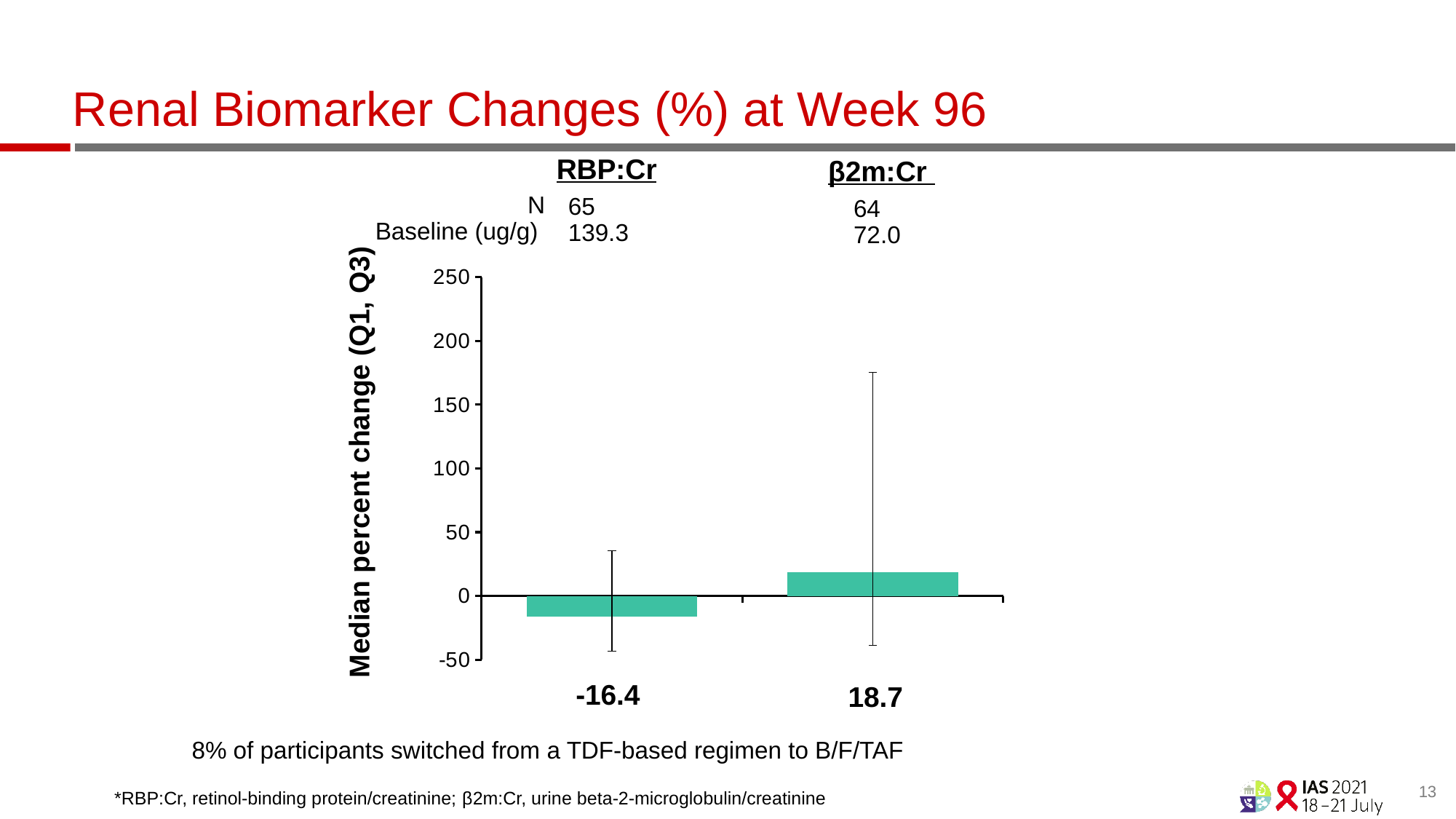
What is the median percent change for β2m:Cr? 18.7 Is the median percent change for β2m:Cr greater or less than 50? less What is the difference between the median percent change for β2m:Cr and RBP:Cr? 35.1 Is the median percent change for β2m:Cr larger than that for RBP:Cr? Yes How many biomarkers are plotted in the chart? 2 Is the median percent change for RBP:Cr greater or less than 0? less Which biomarker has the lower median percent change? RBP:Cr What is the baseline value (ug/g) for β2m:Cr shown above the chart? 72.0 What kind of chart is shown on the slide? bar chart Which biomarker has the higher median percent change? β2m:Cr What is the N for RBP:Cr shown above the chart? 65 What is the median percent change for RBP:Cr? -16.4